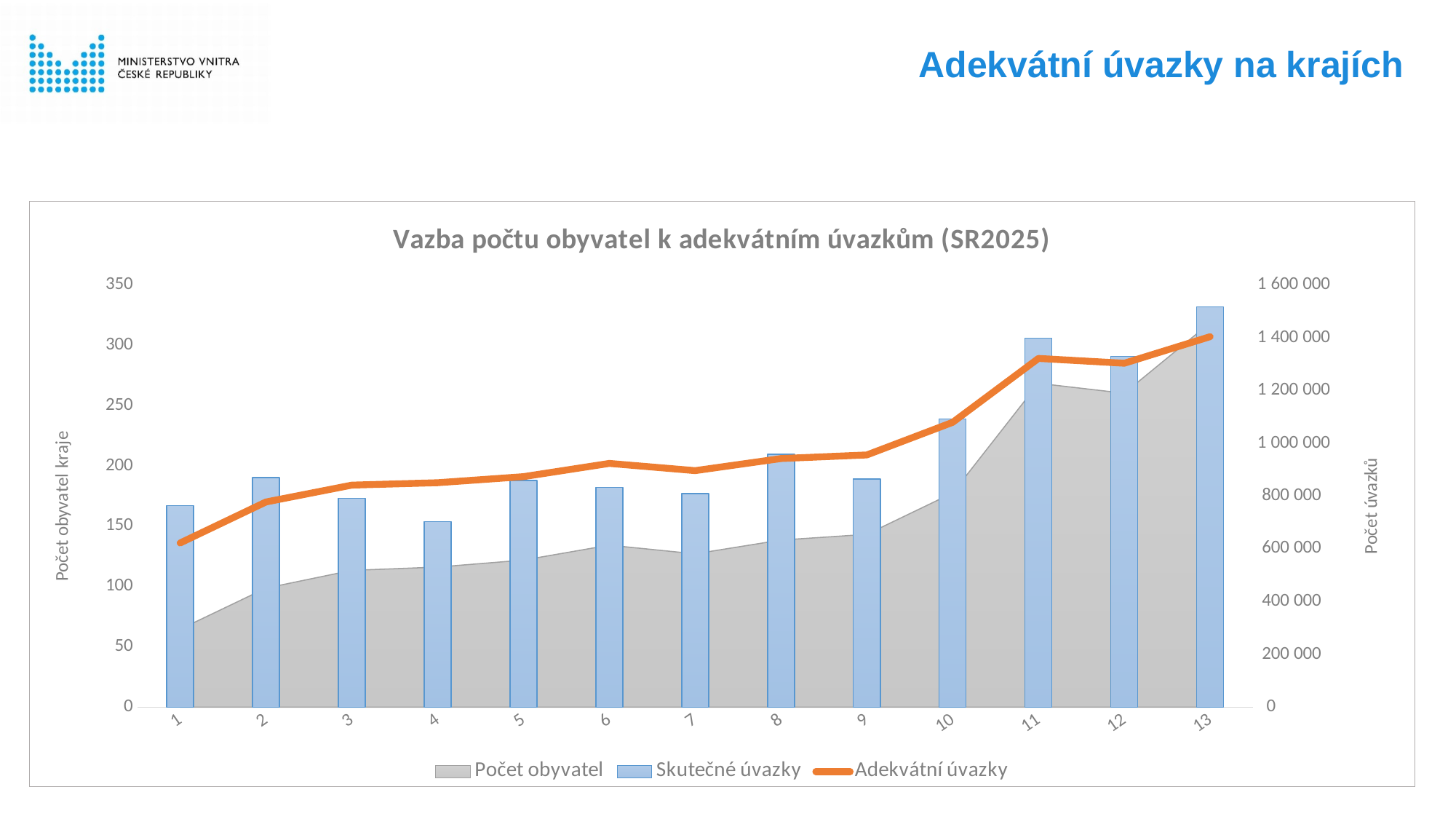
How many categories are shown on the x axis? 13 Is the Skutečné úvazky value for category 13 greater or less than 300? greater Which category has the highest bar for Skutečné úvazky? 13 Does the Adekvátní úvazky line generally rise or fall from category 1 to category 13? rise Which category has the lowest bar for Skutečné úvazky? 4 Which has the larger Skutečné úvazky value, category 10 or category 9? 10 Is the Skutečné úvazky value for category 4 greater or less than 200? less Is the Skutečné úvazky value for category 10 greater or less than 200? greater What is the title of the chart? Vazba počtu obyvatel k adekvátním úvazkům (SR2025) Which series is drawn as an orange line? Adekvátní úvazky How many series does the chart legend list? 3